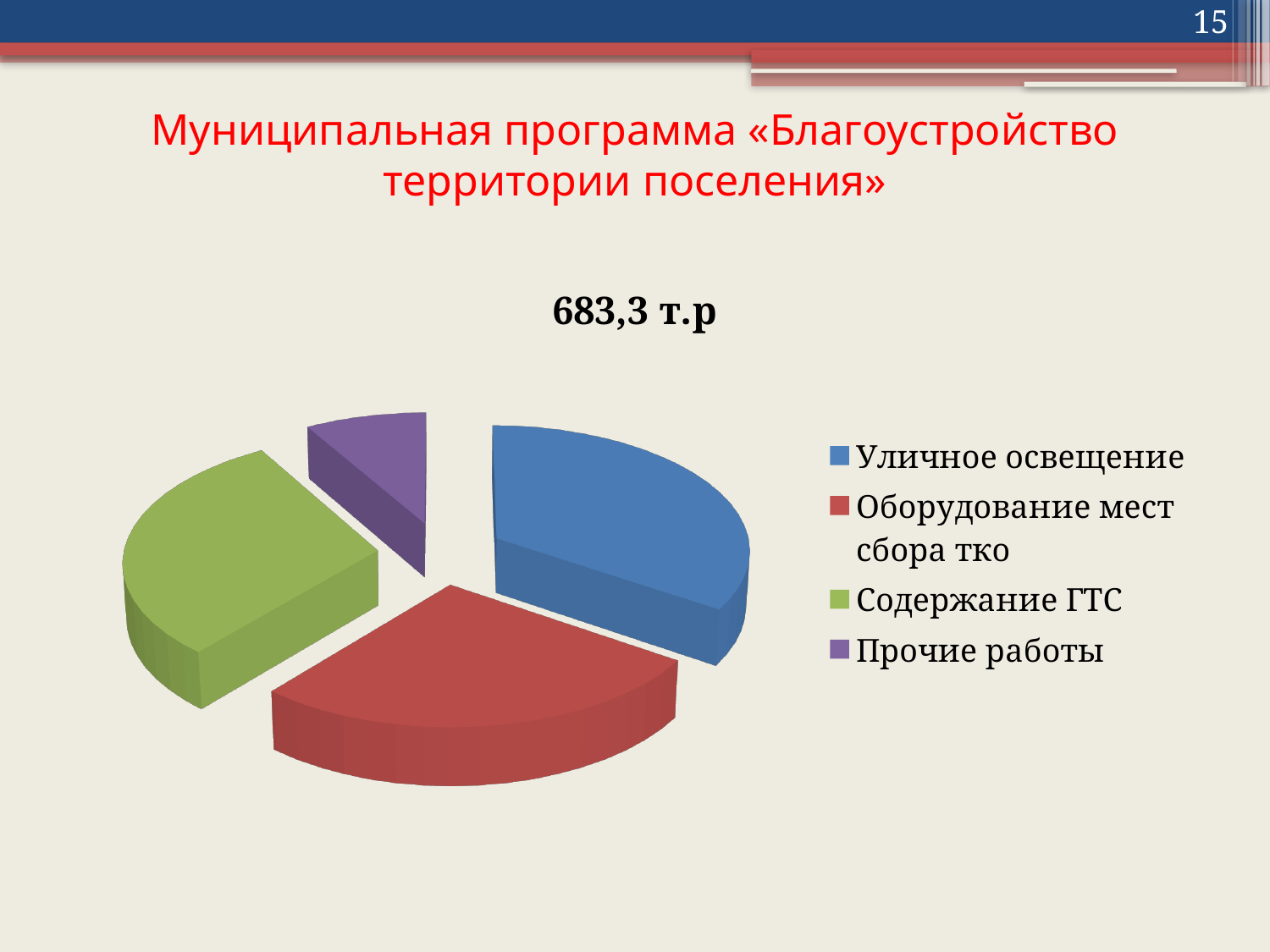
What kind of chart is shown on the slide? pie chart Which slice is larger, Уличное освещение or Прочие работы? Уличное освещение How many entries does the legend of the pie chart list? 4 Which slice is larger, Оборудование мест сбора тко or Прочие работы? Оборудование мест сбора тко What colour is the slice for Содержание ГТС? green What is the title of the pie chart? 683,3 т.р Which slice is larger, Содержание ГТС or Прочие работы? Содержание ГТС Which category has the smallest slice in the pie chart? Прочие работы How many categories does the pie chart have? 4